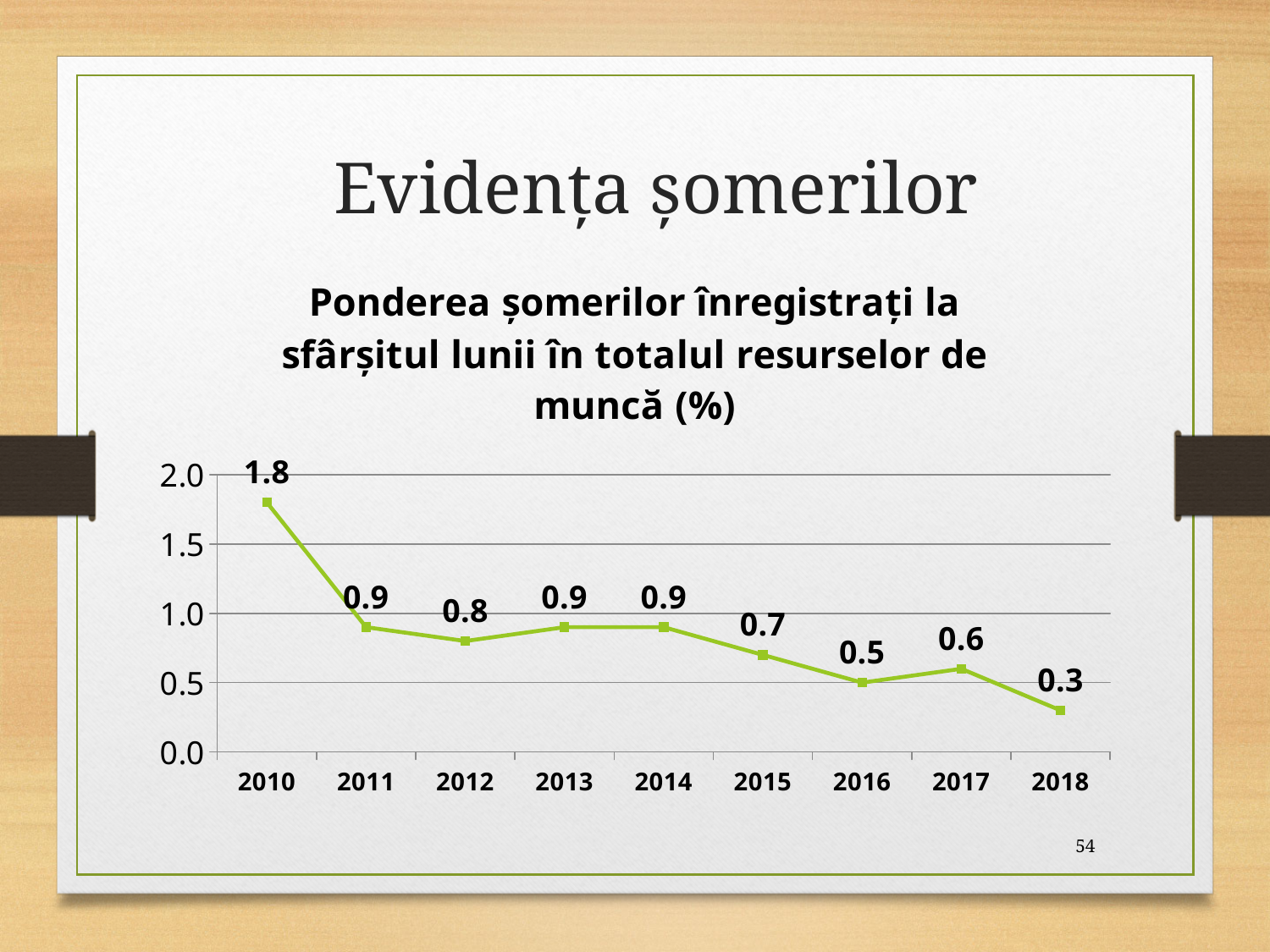
What is the difference between the values for 2010 and 2011? 0.9 What kind of chart is shown? line chart What is the value for 2015? 0.7 Which year has the highest value? 2010 Is the value for 2010 greater or less than 1.5? greater Which year has the lowest value? 2018 Do the values generally rise or fall from 2010 to 2018? fall How many years are plotted on the chart? 9 What is the value for 2010? 1.8 What is the difference between the values for 2017 and 2018? 0.3 What is the value for 2018? 0.3 Which is larger, the value for 2016 or the value for 2017? 2017